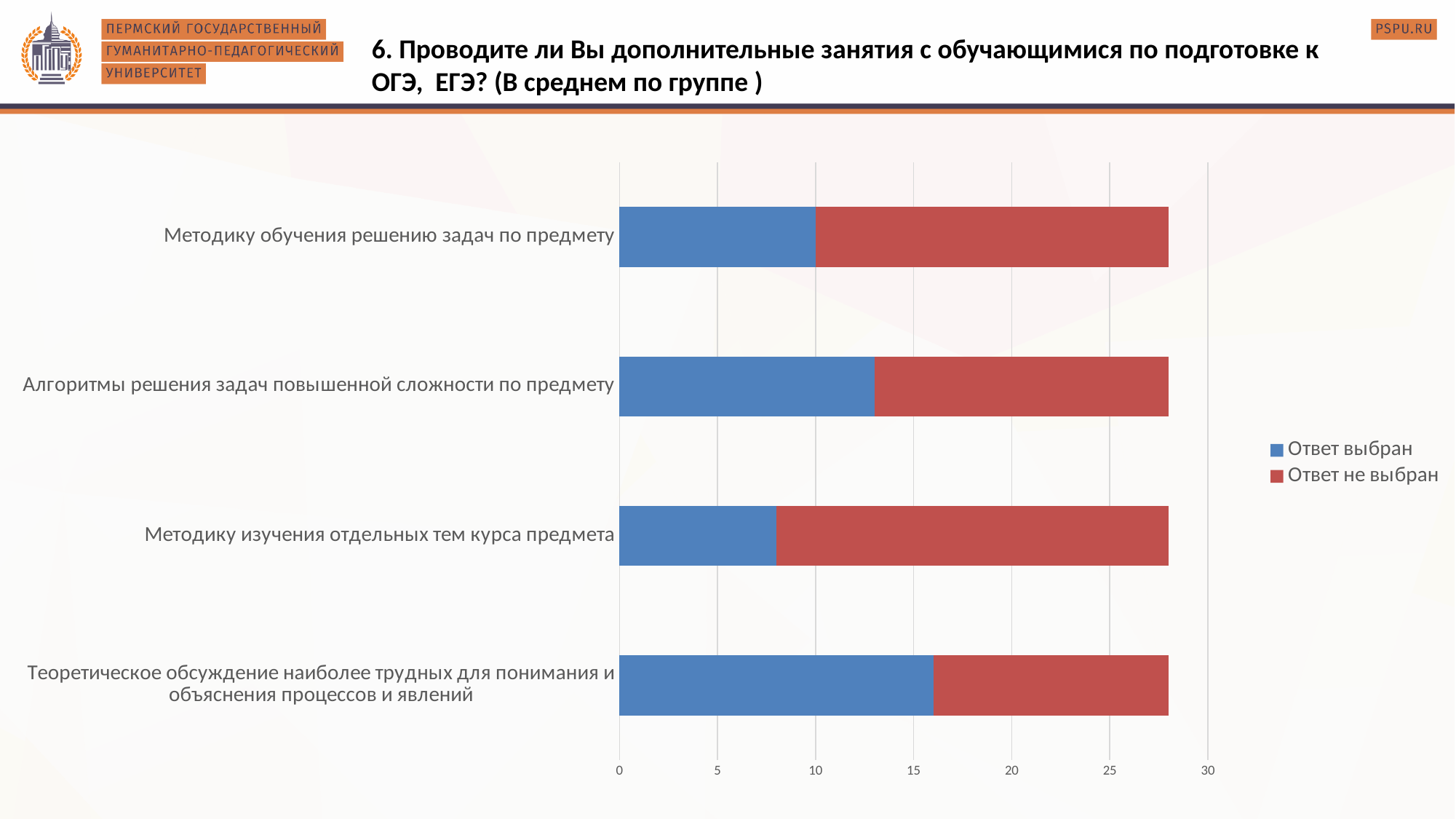
How many categories are plotted on the chart? 4 Is the value of "Ответ выбран" for "Методику изучения отдельных тем курса предмета" greater or less than 10? less Which has a larger "Ответ выбран" value: "Алгоритмы решения задач повышенной сложности по предмету" or "Методику обучения решению задач по предмету"? Алгоритмы решения задач повышенной сложности по предмету What kind of chart is shown on the slide? Stacked bar chart How many series does the legend list? 2 Is the value of "Ответ выбран" for "Алгоритмы решения задач повышенной сложности по предмету" greater or less than 10? greater Which category has the highest value for "Ответ выбран"? Теоретическое обсуждение наиболее трудных для понимания и объяснения процессов и явлений Is the value of "Ответ выбран" for "Теоретическое обсуждение наиболее трудных для понимания и объяснения процессов и явлений" greater or less than 15? greater What is the highest value shown on the horizontal axis? 30 What is the value of "Ответ выбран" for "Методику обучения решению задач по предмету"? 10 Which category has the lowest value for "Ответ выбран"? Методику изучения отдельных тем курса предмета Which series is shown in red? Ответ не выбран